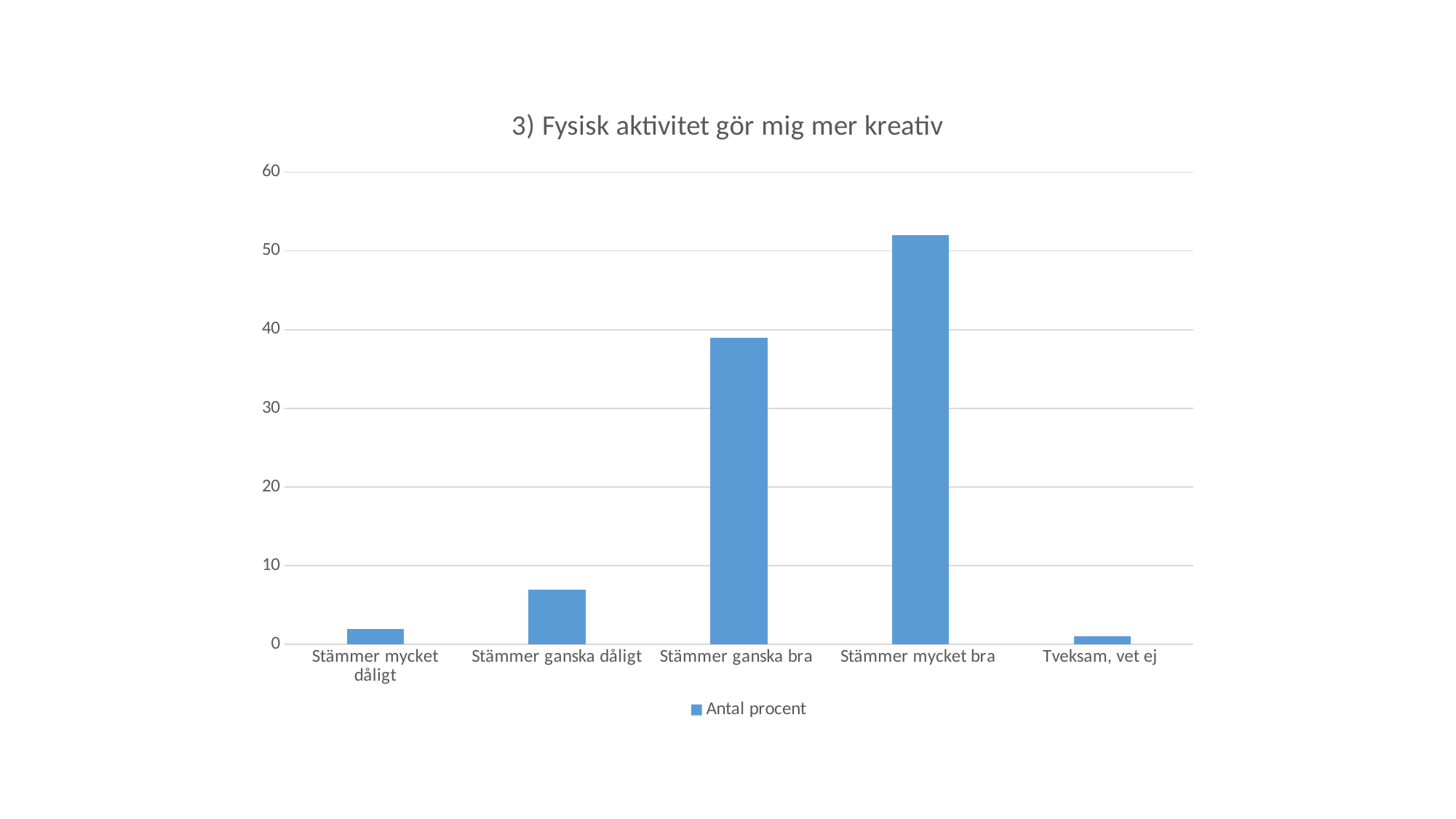
Which is larger, the value for Stämmer ganska bra or the value for Stämmer mycket bra? Stämmer mycket bra How many categories are shown on the x axis? 5 Which category has the highest value? Stämmer mycket bra Which is larger, the value for Stämmer ganska dåligt or the value for Stämmer mycket dåligt? Stämmer ganska dåligt What is the name of the series shown in the legend? Antal procent Is the value for Tveksam, vet ej greater or less than 10? less Is the value for Stämmer ganska dåligt greater or less than 10? less How many series does the legend list? 1 What kind of chart is shown on the slide? bar chart Is the value for Stämmer mycket bra greater or less than 40? greater What is the title of the chart? 3) Fysisk aktivitet gör mig mer kreativ